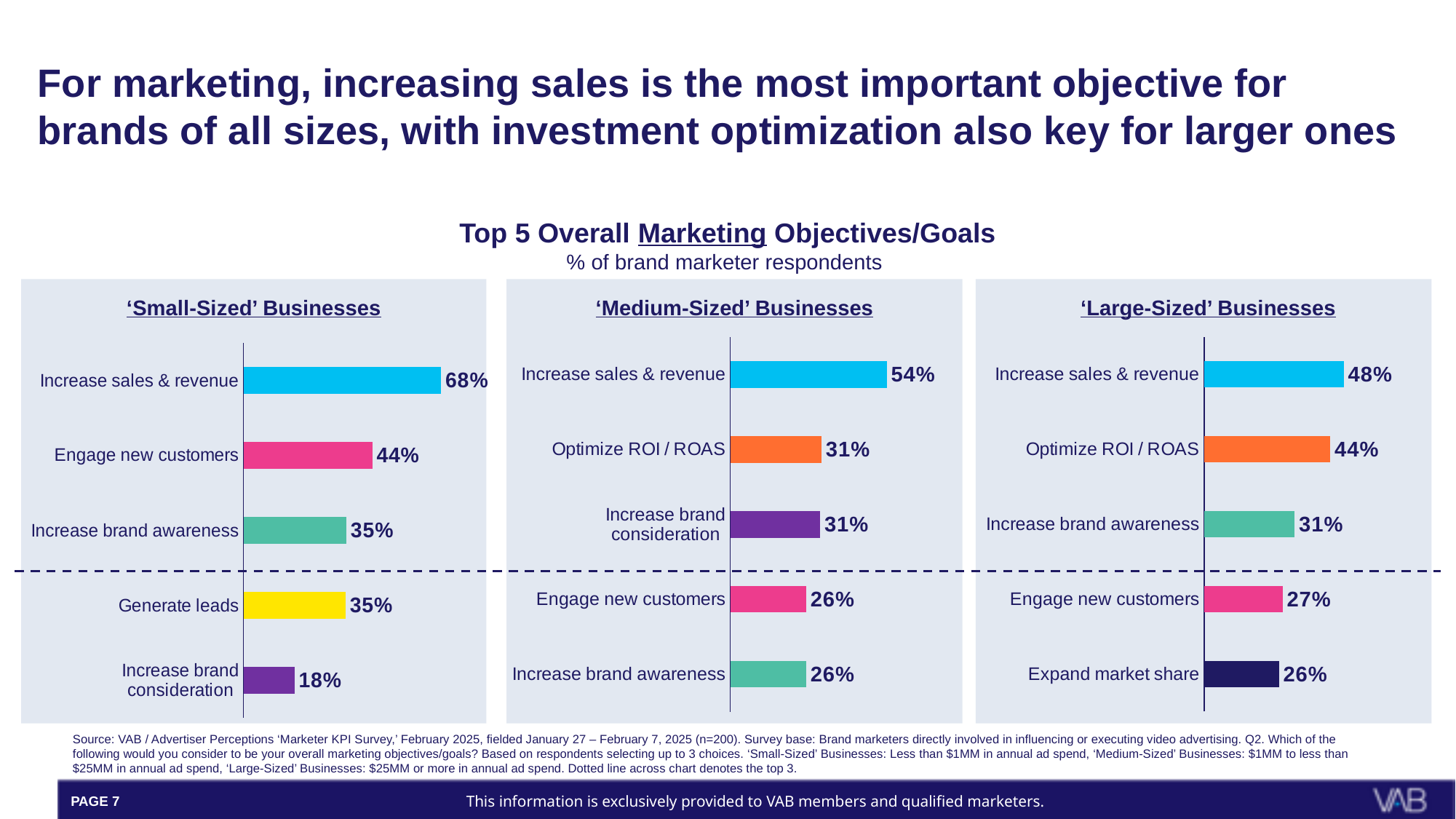
In the 'Medium-Sized' Businesses chart, what is the value for Optimize ROI / ROAS? 31% In the 'Large-Sized' Businesses chart, what is the value for Expand market share? 26% In the 'Small-Sized' Businesses chart, what percentage of respondents selected Increase sales & revenue? 68% Which is larger: Optimize ROI / ROAS in the 'Medium-Sized' Businesses chart or Optimize ROI / ROAS in the 'Large-Sized' Businesses chart? 'Large-Sized' Businesses In the 'Large-Sized' Businesses chart, which objective has the highest value? Increase sales & revenue In the 'Large-Sized' Businesses chart, what is the difference between Optimize ROI / ROAS and Increase brand awareness? 13% In the 'Small-Sized' Businesses chart, which objective has the lowest value? Increase brand consideration In the 'Small-Sized' Businesses chart, what is the difference between Increase sales & revenue and Engage new customers? 24% How many objectives are shown in the 'Medium-Sized' Businesses chart? 5 How many separate charts are shown on the slide? 3 What type of chart is used for the 'Small-Sized' Businesses data? Bar chart According to the source note, what does the dotted line across the charts denote? The top 3